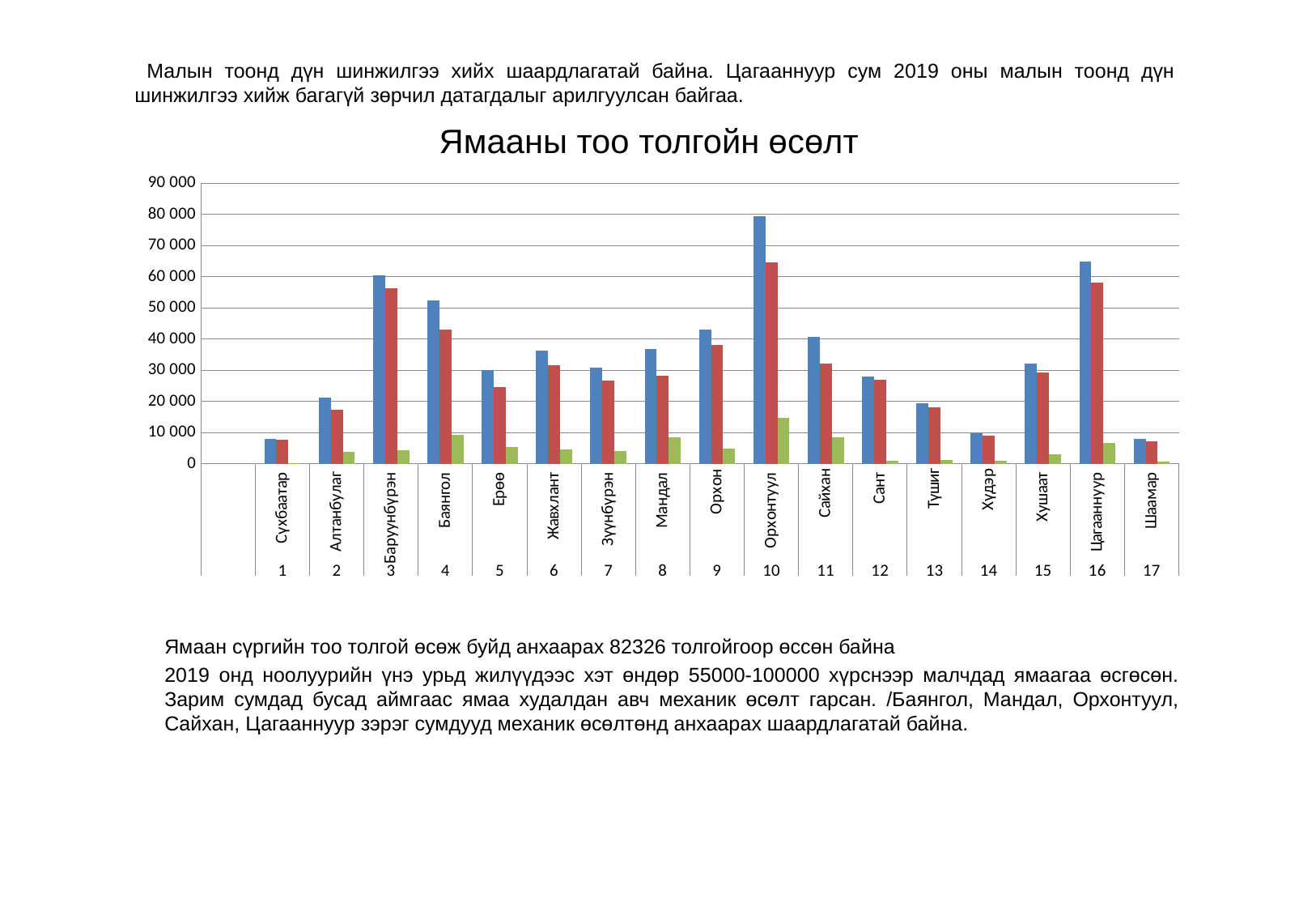
Is the blue bar for Орхонтуул greater or less than 70 000? greater Which category has the tallest green bar in the chart? Орхонтуул How many bars are plotted for each category in the chart? 3 How many categories (sums) are shown along the x axis of the chart? 17 Is the blue bar for Сүхбаатар greater or less than 10 000? less What is the title of the chart? Ямааны тоо толгойн өсөлт Which category has the tallest blue bar in the chart? Орхонтуул What kind of chart is shown on the slide? bar chart Which has the larger blue bar, Орхонтуул or Цагааннуур? Орхонтуул Which has the larger blue bar, Алтанбулаг or Ерөө? Ерөө Is the blue bar for Түшиг greater or less than 30 000? less